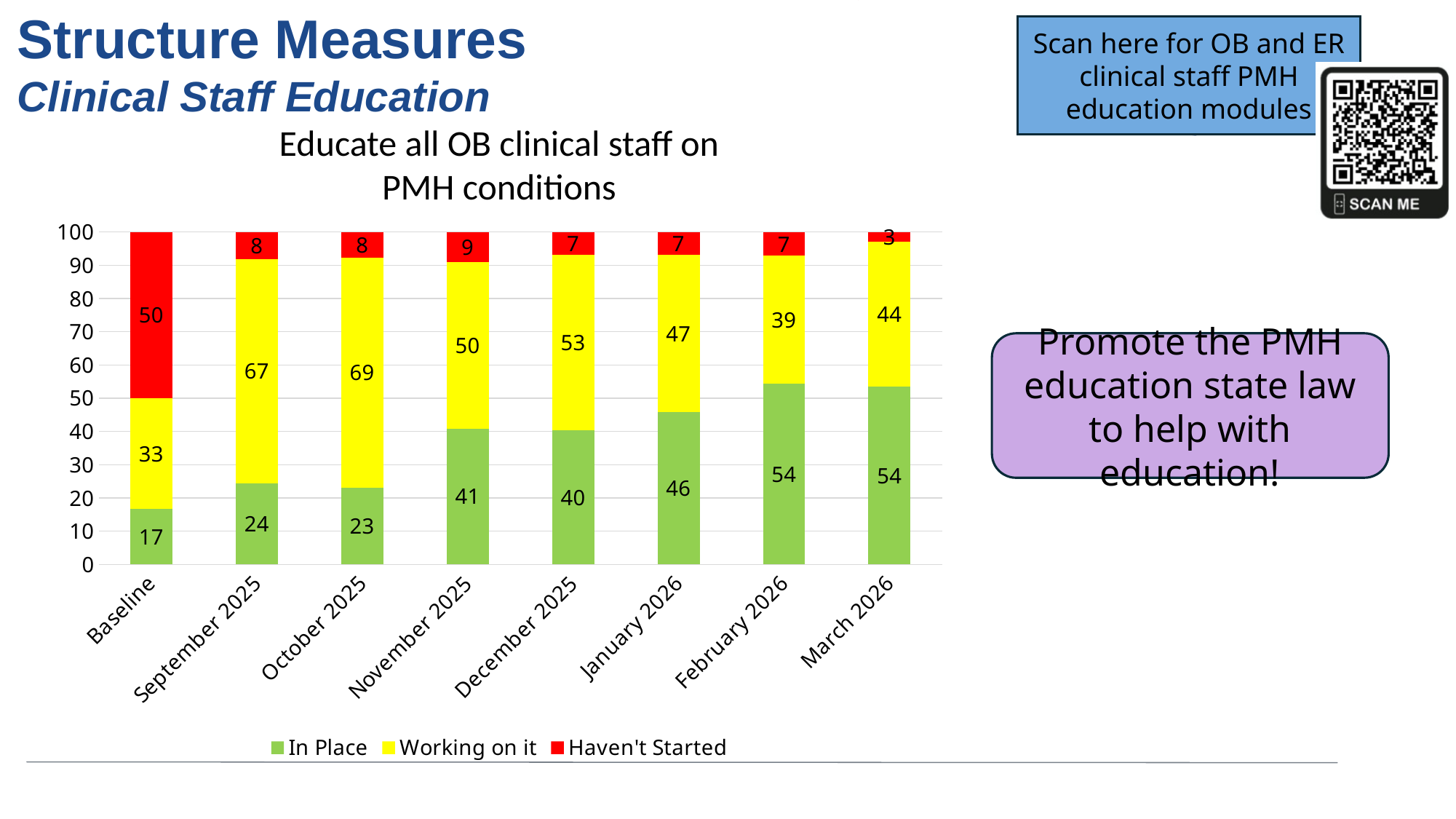
What type of chart is shown on the slide? Stacked bar chart Does the 'In Place' value rise or fall from Baseline to March 2026? Rise What is the 'Haven't Started' value for March 2026? 3 What is the 'In Place' value for Baseline? 17 Which category has the lowest 'In Place' value? Baseline What is the 'Working on it' value for October 2025? 69 How many series does the legend list? 3 How many categories are shown on the x axis? 8 What is the difference between the 'In Place' values for February 2026 and Baseline? 37 What is the title of the chart? Educate all OB clinical staff on PMH conditions Which is larger: the 'Working on it' value for September 2025 or for November 2025? September 2025 Which category has the highest 'Haven't Started' value? Baseline